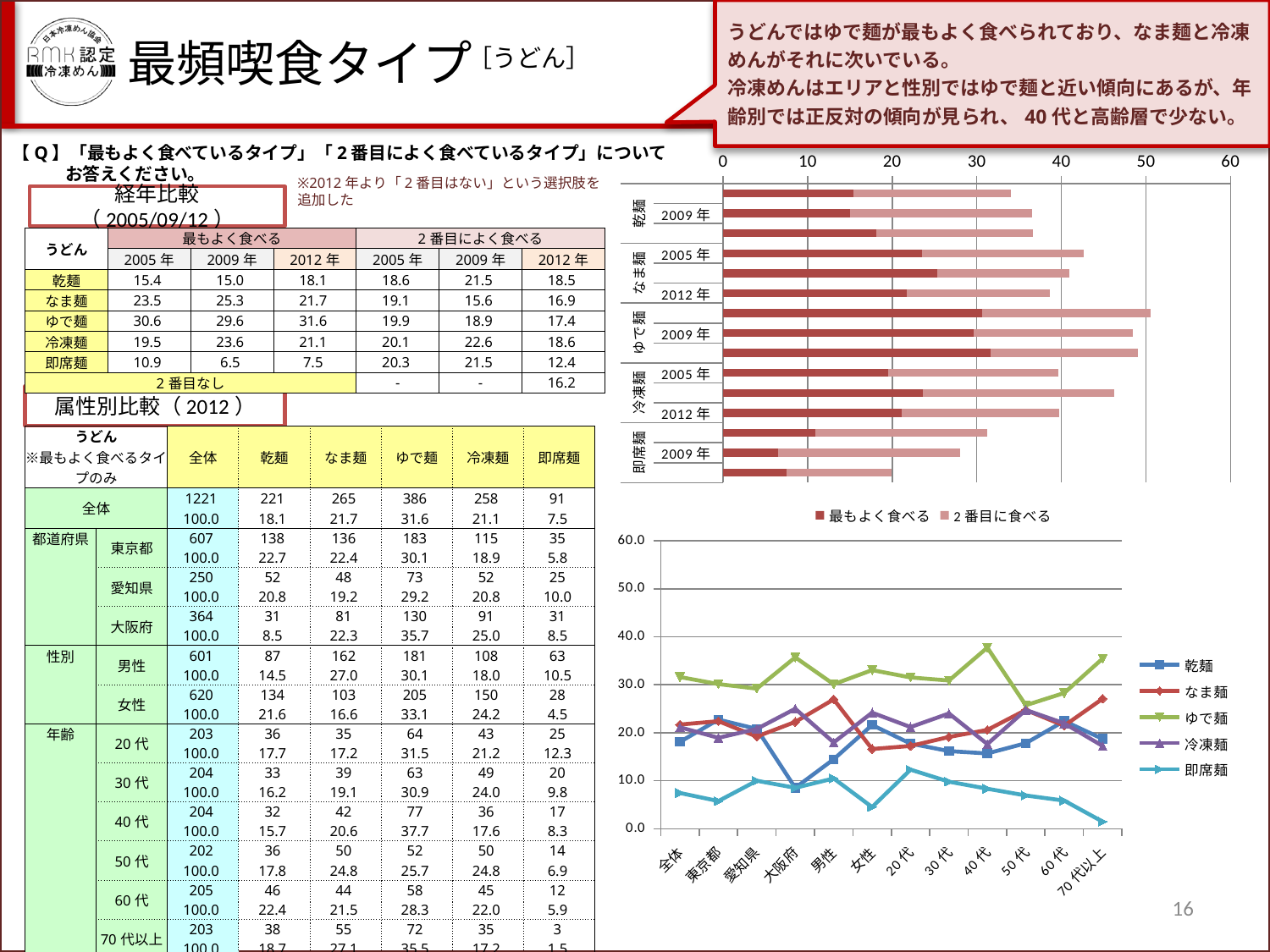
How many categories are on the x axis of the bottom-right line chart? 12 How many series does the legend of the top-right bar chart list? 2 In the bottom-right line chart, which series has the lowest value at 全体? 即席麺 How many series does the legend of the bottom-right line chart list? 5 What kind of chart is the chart in the bottom right of the slide? line chart What kind of chart is the chart in the top right of the slide? bar chart In the bottom-right line chart, is the value of ゆで麺 at 40代 greater or less than 30? greater In the bottom-right line chart, which series has the highest value at 40代? ゆで麺 In the bottom-right line chart, is the value of 即席麺 at 70代以上 greater or less than 10? less In the top-right bar chart, is the 最もよく食べる value for 即席麺 in 2009年 greater or less than 10? less In the bottom-right line chart, does the 即席麺 line rise or fall from 20代 to 70代以上? fall In the top-right bar chart, which noodle type has the longest 最もよく食べる bars? ゆで麺